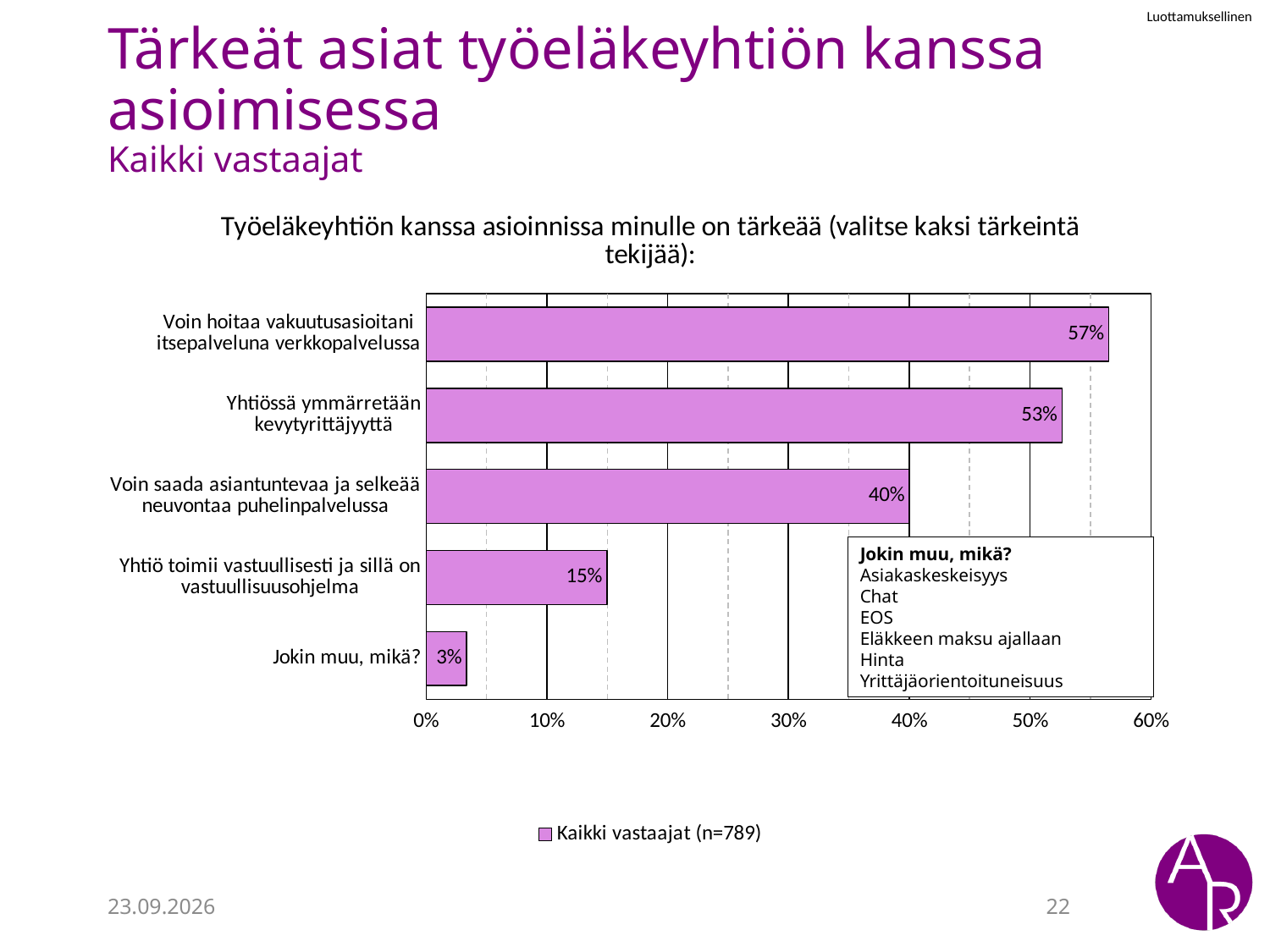
What is the value for "Voin hoitaa vakuutusasioitani itsepalveluna verkkopalvelussa"? 57% What is the value for "Voin saada asiantuntevaa ja selkeää neuvontaa puhelinpalvelussa"? 40% What is the value for "Yhtiö toimii vastuullisesti ja sillä on vastuullisuusohjelma"? 15% Which is larger: the value for "Yhtiössä ymmärretään kevytyrittäjyyttä" or the value for "Yhtiö toimii vastuullisesti ja sillä on vastuullisuusohjelma"? Yhtiössä ymmärretään kevytyrittäjyyttä What is the value for "Yhtiössä ymmärretään kevytyrittäjyyttä"? 53% What kind of chart is shown on the slide? Bar chart What series does the legend list? Kaikki vastaajat (n=789) Which category has the lowest value? Jokin muu, mikä? What is the value for "Jokin muu, mikä?"? 3% What is the difference between the values for "Voin hoitaa vakuutusasioitani itsepalveluna verkkopalvelussa" and "Voin saada asiantuntevaa ja selkeää neuvontaa puhelinpalvelussa"? 17% How many categories are shown in the chart? 5 Which category has the highest value? Voin hoitaa vakuutusasioitani itsepalveluna verkkopalvelussa